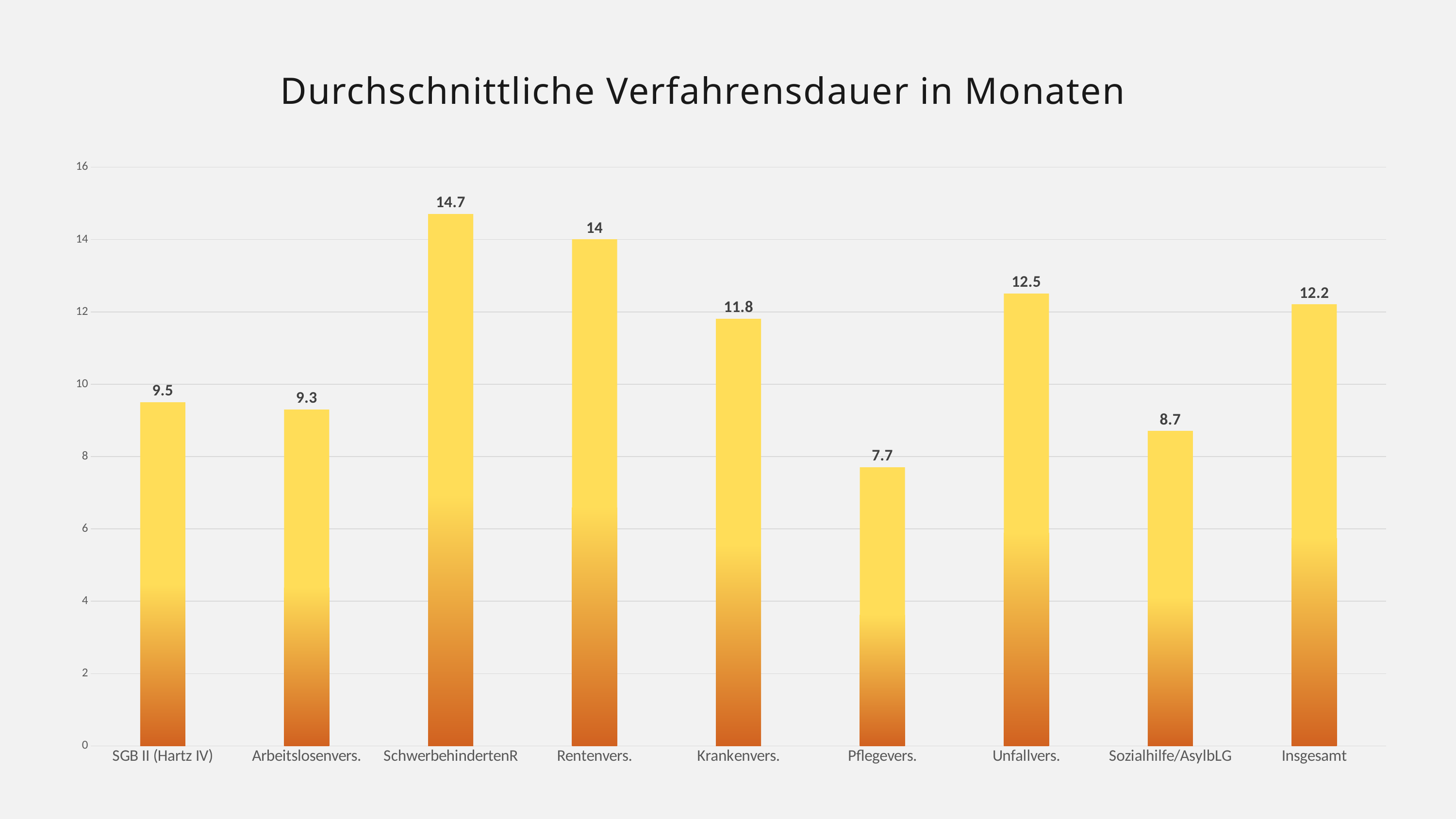
What is the value for Pflegevers.? 7.7 What is the value for Insgesamt? 12.2 What is the title of the chart? Durchschnittliche Verfahrensdauer in Monaten Is the value for Sozialhilfe/AsylbLG greater or less than 10? less Which is larger, the value for Unfallvers. or the value for Insgesamt? Unfallvers. Which category has the highest value? SchwerbehindertenR Which category has the lowest value? Pflegevers. What kind of chart is shown on the slide? bar chart What is the value for SchwerbehindertenR? 14.7 How many categories are shown on the x axis? 9 What is the difference between the values for Rentenvers. and Krankenvers.? 2.2 What is the difference between the values for SGB II (Hartz IV) and Arbeitslosenvers.? 0.2